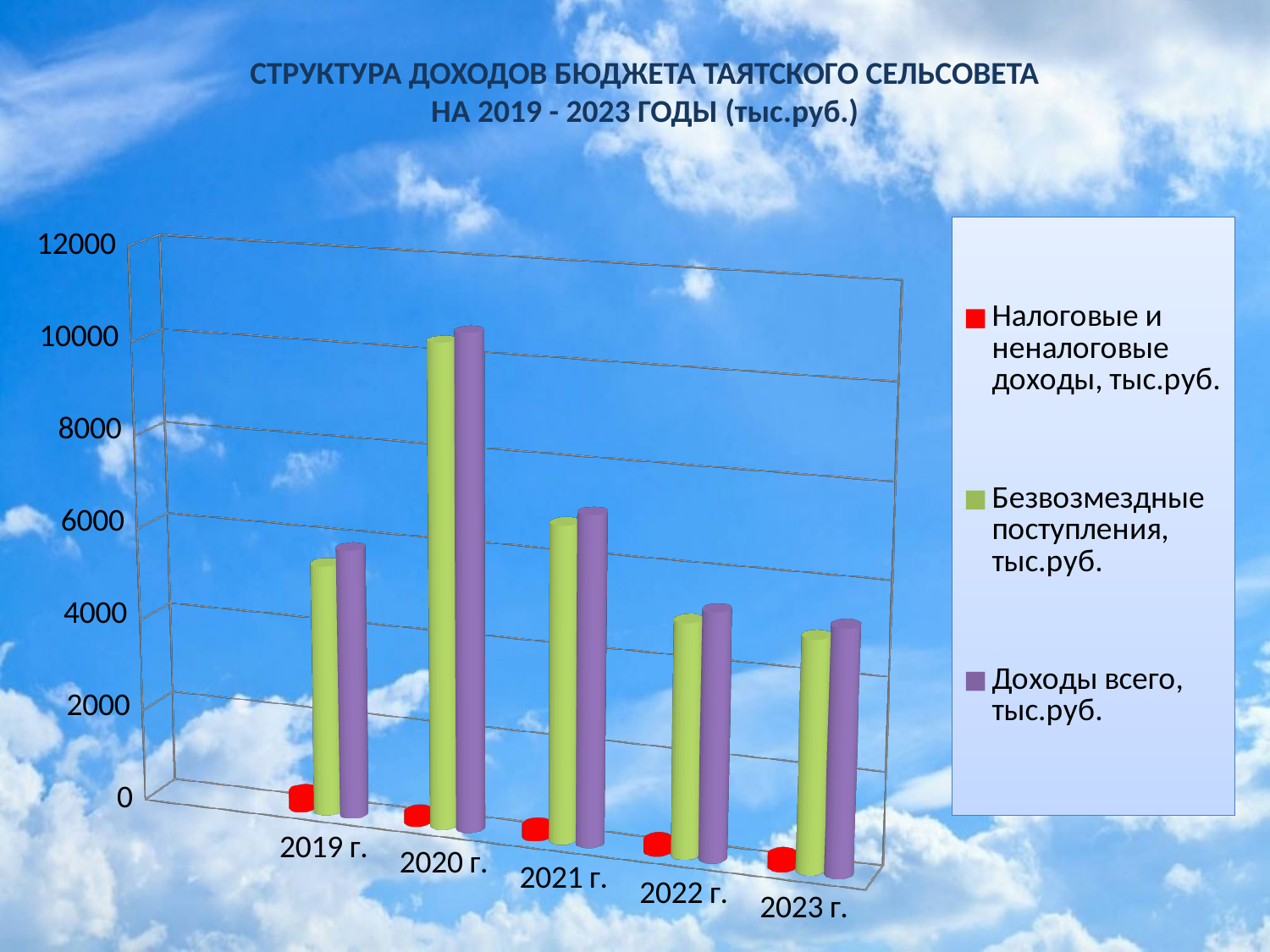
What colour represents Доходы всего, тыс.руб. in the chart legend? Purple In which year is the value for Доходы всего, тыс.руб. the highest? 2020 г. What kind of chart is shown on the slide? Bar chart Is the value for Безвозмездные поступления, тыс.руб. in 2022 г. greater or less than 6000? less Which is larger: Доходы всего, тыс.руб. in 2020 г. or in 2021 г.? 2020 г. Is the value for Налоговые и неналоговые доходы, тыс.руб. in 2020 г. greater or less than 2000? less In which year is the value for Безвозмездные поступления, тыс.руб. the highest? 2020 г. Is the value for Безвозмездные поступления, тыс.руб. in 2019 г. greater or less than 4000? greater How many years (categories) are shown on the x axis of the chart? 5 How many series does the chart legend list? 3 From 2020 г. to 2023 г., do the values for Доходы всего, тыс.руб. rise or fall? Fall